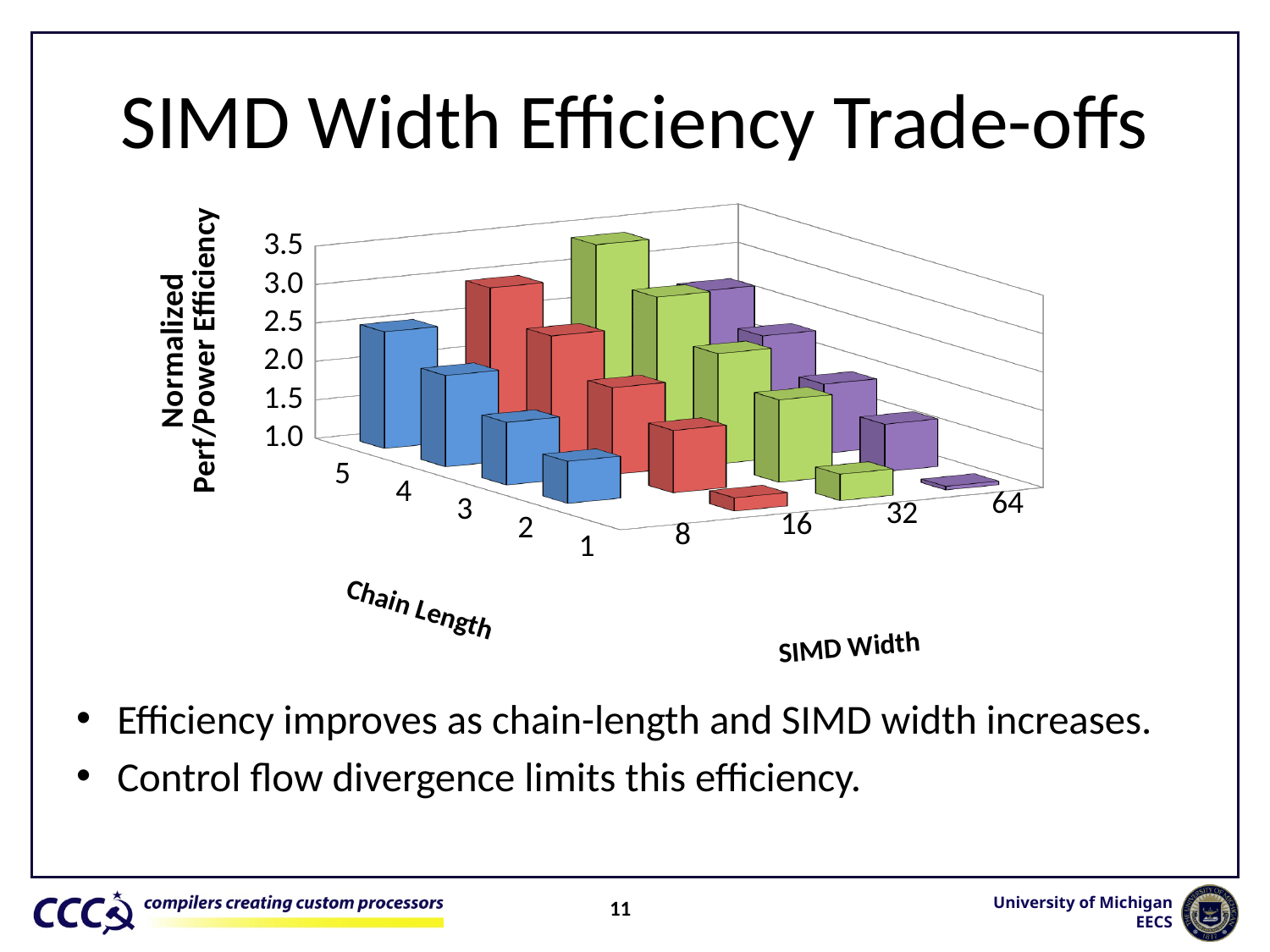
How many SIMD width values are plotted along the SIMD Width axis? 4 What kind of chart is shown on the slide? 3D bar chart What is the highest tick value shown on the vertical axis? 3.5 For SIMD width 32, does the efficiency rise or fall as chain length increases from 1 to 5? rise What is the lowest tick value shown on the vertical axis? 1.0 Is the value for SIMD width 16 at chain length 1 greater or less than 1.5? less What is the label of the vertical axis? Normalized Perf/Power Efficiency Which chain length gives the shortest bar for SIMD width 64? 1 How many chain length values are plotted along the Chain Length axis? 5 What is the title of the chart? SIMD Width Efficiency Trade-offs Which chain length gives the tallest bar for SIMD width 32? 5 Which is taller: the bar for SIMD width 32 at chain length 5 or the bar for SIMD width 8 at chain length 5? SIMD width 32 at chain length 5